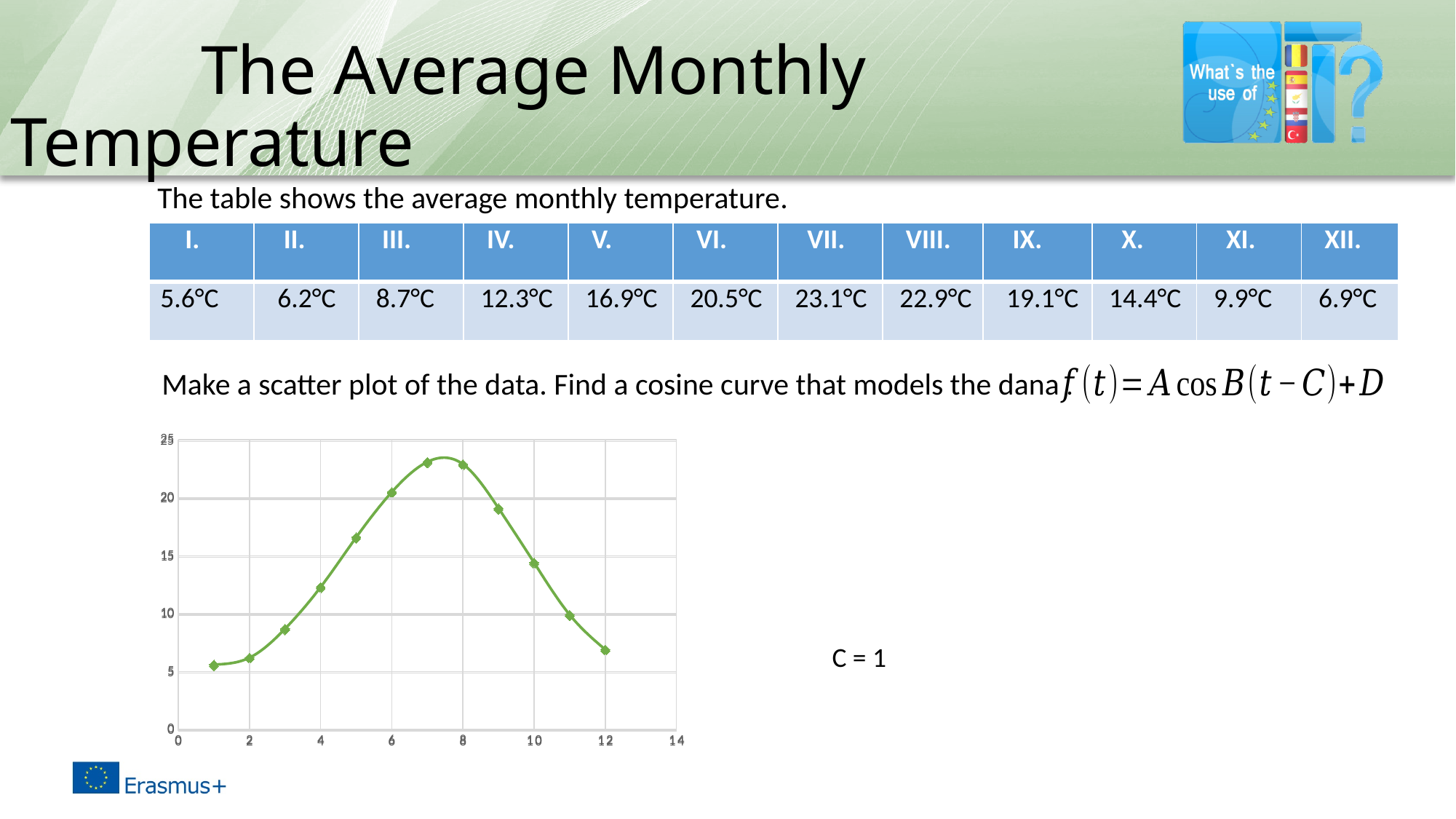
According to the table, what is the average temperature for month VII? 23.1°C According to the table, what is the average temperature for month I? 5.6°C How many data points are plotted on the chart? 12 At which month number is the plotted temperature lowest? 1 At which month number does the plotted temperature reach its highest point? 7 What is the difference between the highest (VII) and lowest (I) average monthly temperatures in the table? 17.5°C How does the plotted temperature change from month 1 to month 7 along the x axis? it rises On the chart, is the value at month 9 greater or less than 20? less What kind of chart is shown on the slide? scatter plot On the chart, is the value at month 10 greater or less than 15? less Which has the higher plotted temperature, month 5 or month 9? month 9 On the chart, is the value at month 4 greater or less than 10? greater